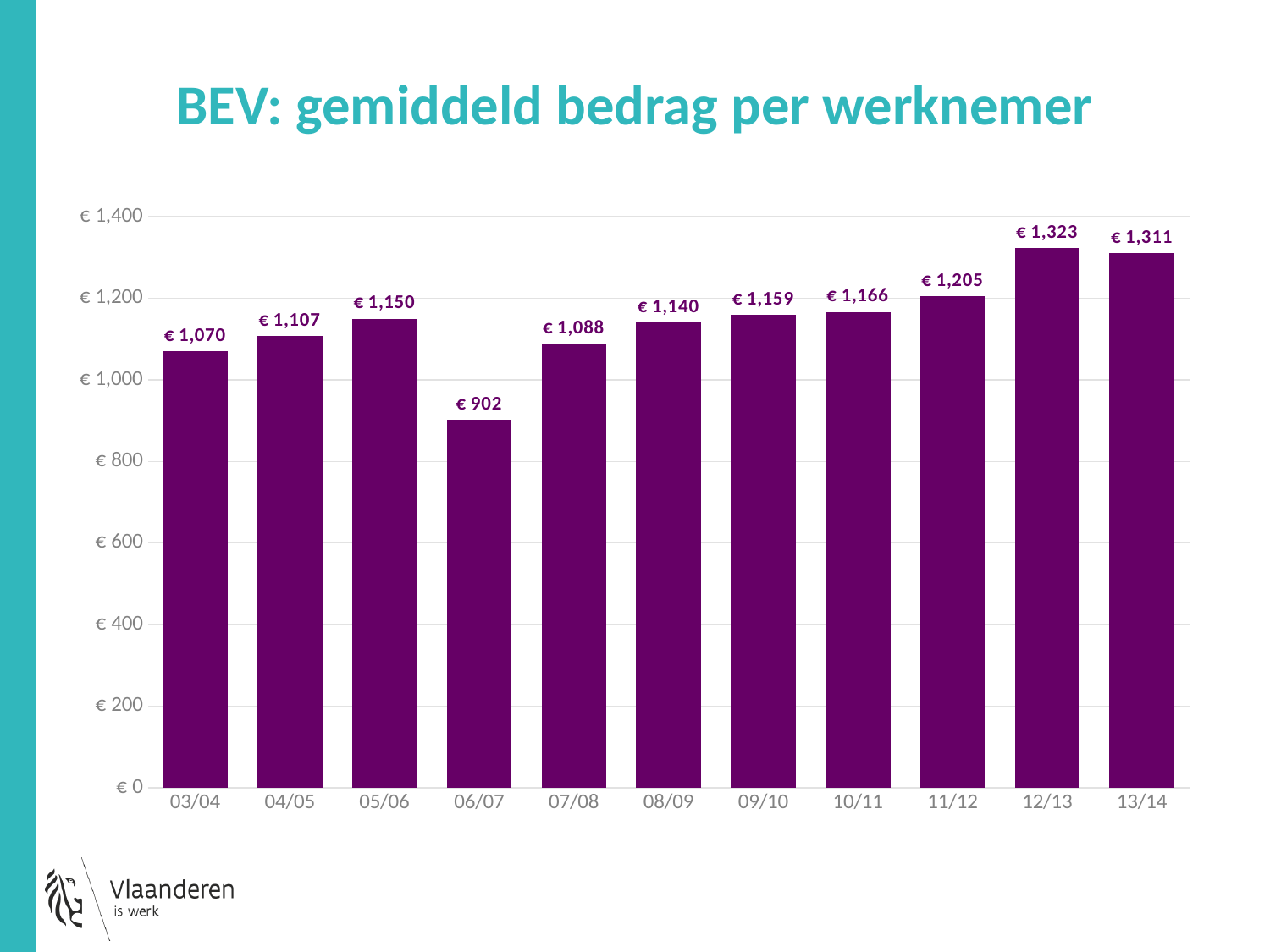
How many years are shown on the x axis? 11 Which year has the lowest value? 06/07 What is the value for 11/12? € 1,205 Which is larger, the value for 04/05 or the value for 07/08? 04/05 What is the difference between the values for 12/13 and 13/14? € 12 What is the value for 06/07? € 902 What kind of chart is this? bar chart What is the title of the chart? BEV: gemiddeld bedrag per werknemer Is the value for 10/11 greater or less than € 1,000? greater Which year has the highest value? 12/13 What is the difference between the values for 05/06 and 06/07? € 248 What is the value for 03/04? € 1,070